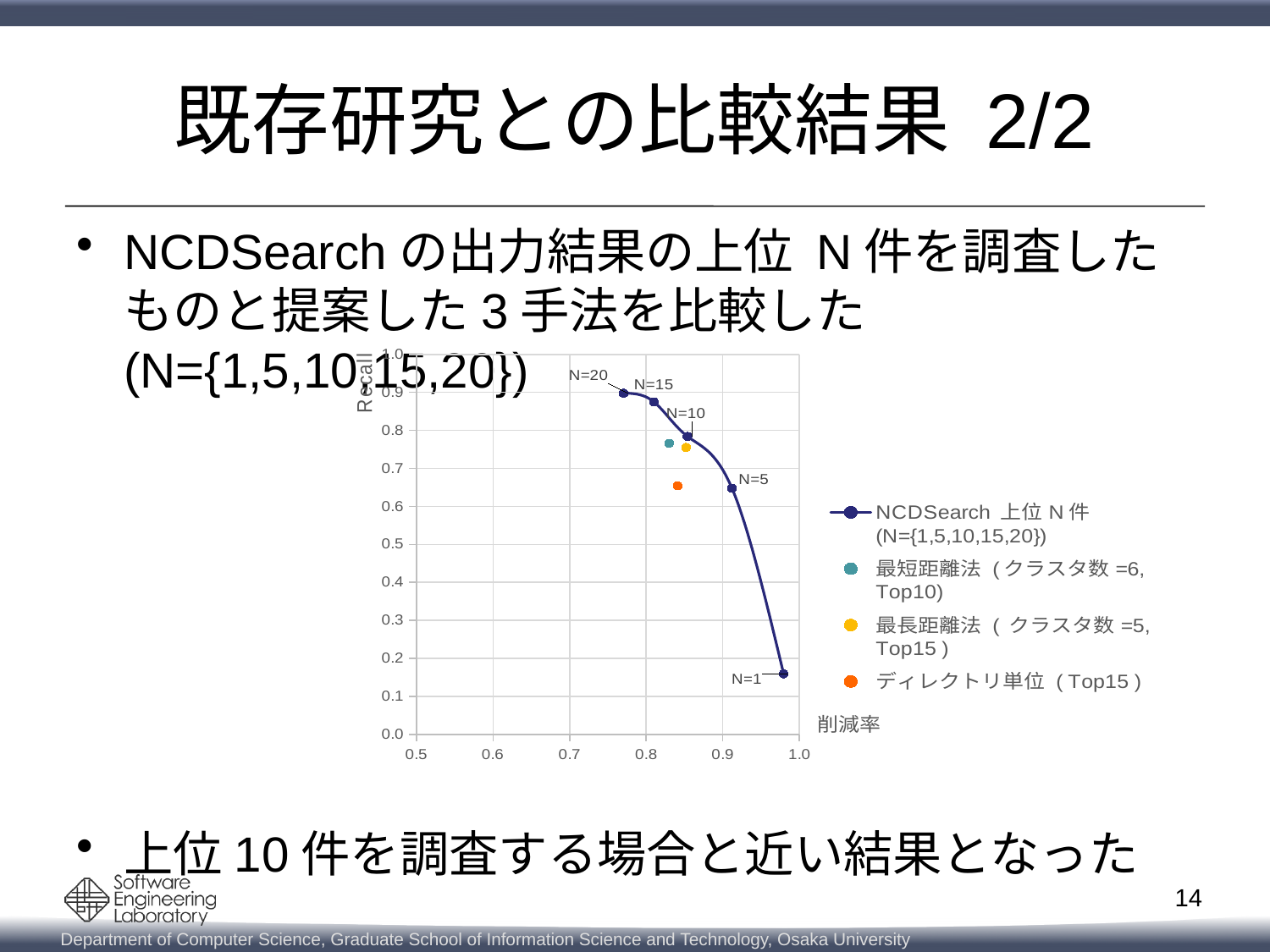
What is the label of the vertical axis of the chart? Recall Is the Recall for ディレクトリ単位 (Top15) greater or less than 0.6? greater Which has the higher Recall, 最短距離法 or ディレクトリ単位 (Top15)? 最短距離法 Is the Recall for N=5 greater or less than 0.6? greater Which N value on the NCDSearch line has the lowest Recall? N=1 How many series does the chart legend list? 4 Is the Recall for N=1 greater or less than 0.2? less What kind of chart is shown on the slide? scatter chart Which N value on the NCDSearch line has the highest 削減率? N=1 As 削減率 increases along the x axis, does Recall on the NCDSearch line rise or fall? fall How many points are plotted on the NCDSearch 上位N件 line? 5